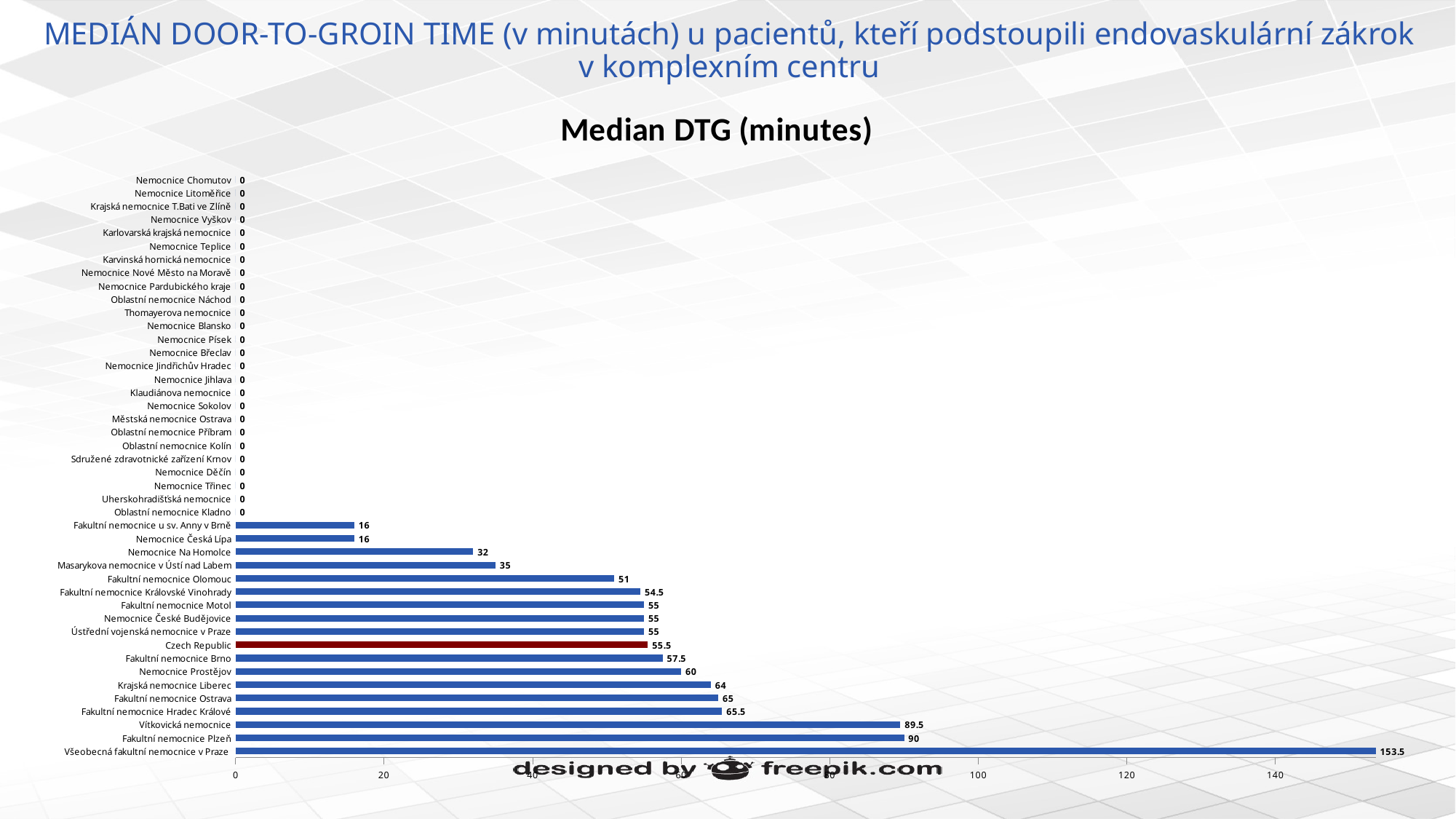
What kind of chart is shown on the slide? bar chart Which has a larger median DTG, Fakultní nemocnice Olomouc or Nemocnice Prostějov? Nemocnice Prostějov What is the difference between the values for Všeobecná fakultní nemocnice v Praze and Fakultní nemocnice Plzeň? 63.5 What is the difference between the values for Fakultní nemocnice Plzeň and Vítkovická nemocnice? 0.5 What colour is the bar for Czech Republic? dark red What is the median DTG value for Czech Republic? 55.5 Which hospital has the highest median DTG? Všeobecná fakultní nemocnice v Praze What is the median DTG value for Všeobecná fakultní nemocnice v Praze? 153.5 What is the median DTG value for Nemocnice Na Homolce? 32 What is the median DTG value for Fakultní nemocnice Plzeň? 90 Is the value for Vítkovická nemocnice greater or less than 80? greater What is the title of the chart? Median DTG (minutes)